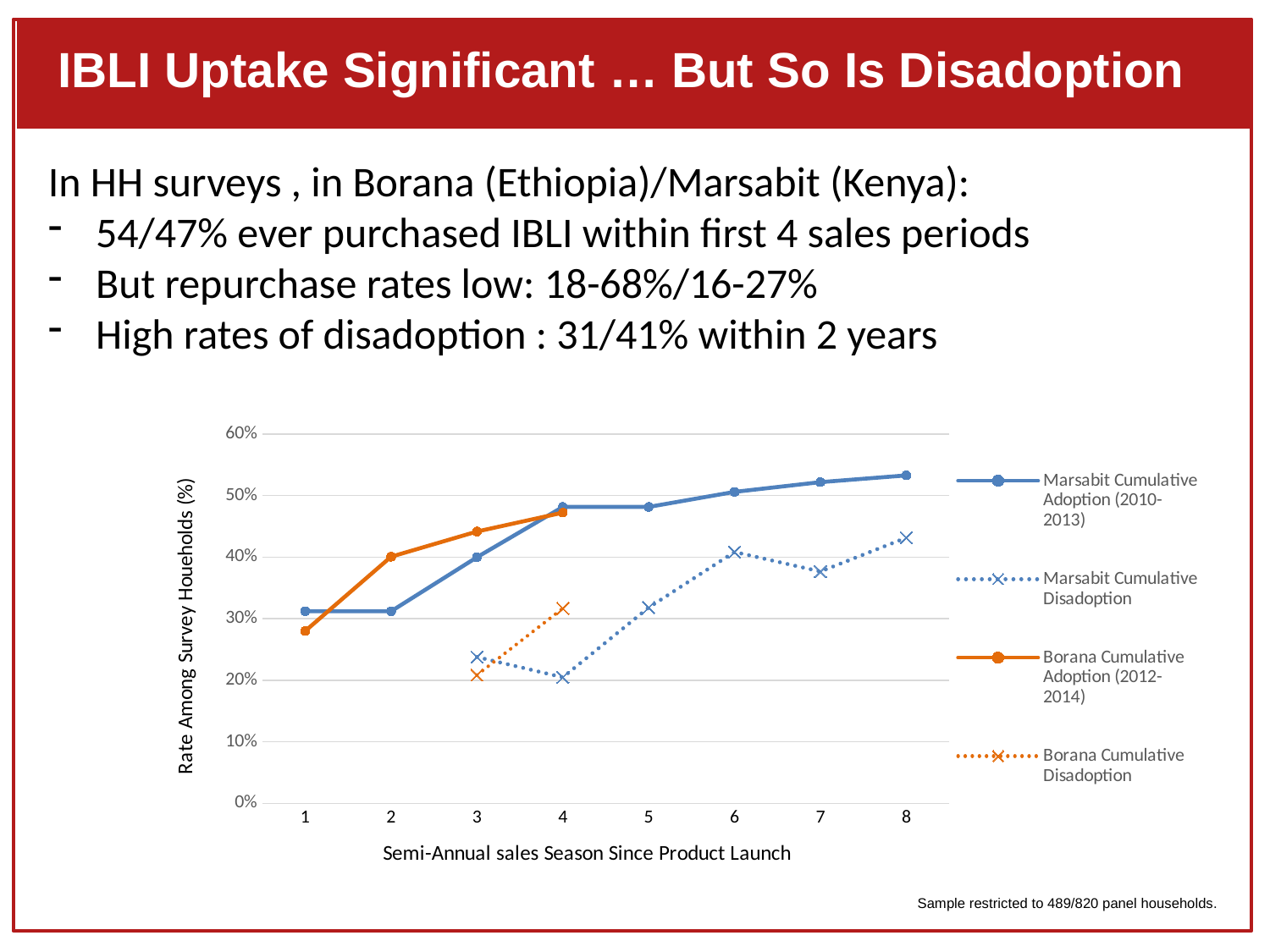
How many data points are plotted for the Marsabit Cumulative Adoption (2010-2013) series? 8 How many series does the chart legend list? 4 How many data points are plotted for the Borana Cumulative Adoption (2012-2014) series? 4 Is the value for Marsabit Cumulative Adoption (2010-2013) at season 8 greater or less than 50%? greater In which season is the Marsabit Cumulative Disadoption series at its lowest? 4 What kind of chart is shown on the slide? Line chart Is the value for Marsabit Cumulative Disadoption at season 6 greater or less than 30%? greater Does the Marsabit Cumulative Adoption (2010-2013) series generally rise or fall across the sales seasons? Rise Is the value for Borana Cumulative Disadoption at season 3 greater or less than 30%? less At season 2, which is higher: Borana Cumulative Adoption (2012-2014) or Marsabit Cumulative Adoption (2010-2013)? Borana Cumulative Adoption (2012-2014) What is the title of the x axis? Semi-Annual sales Season Since Product Launch